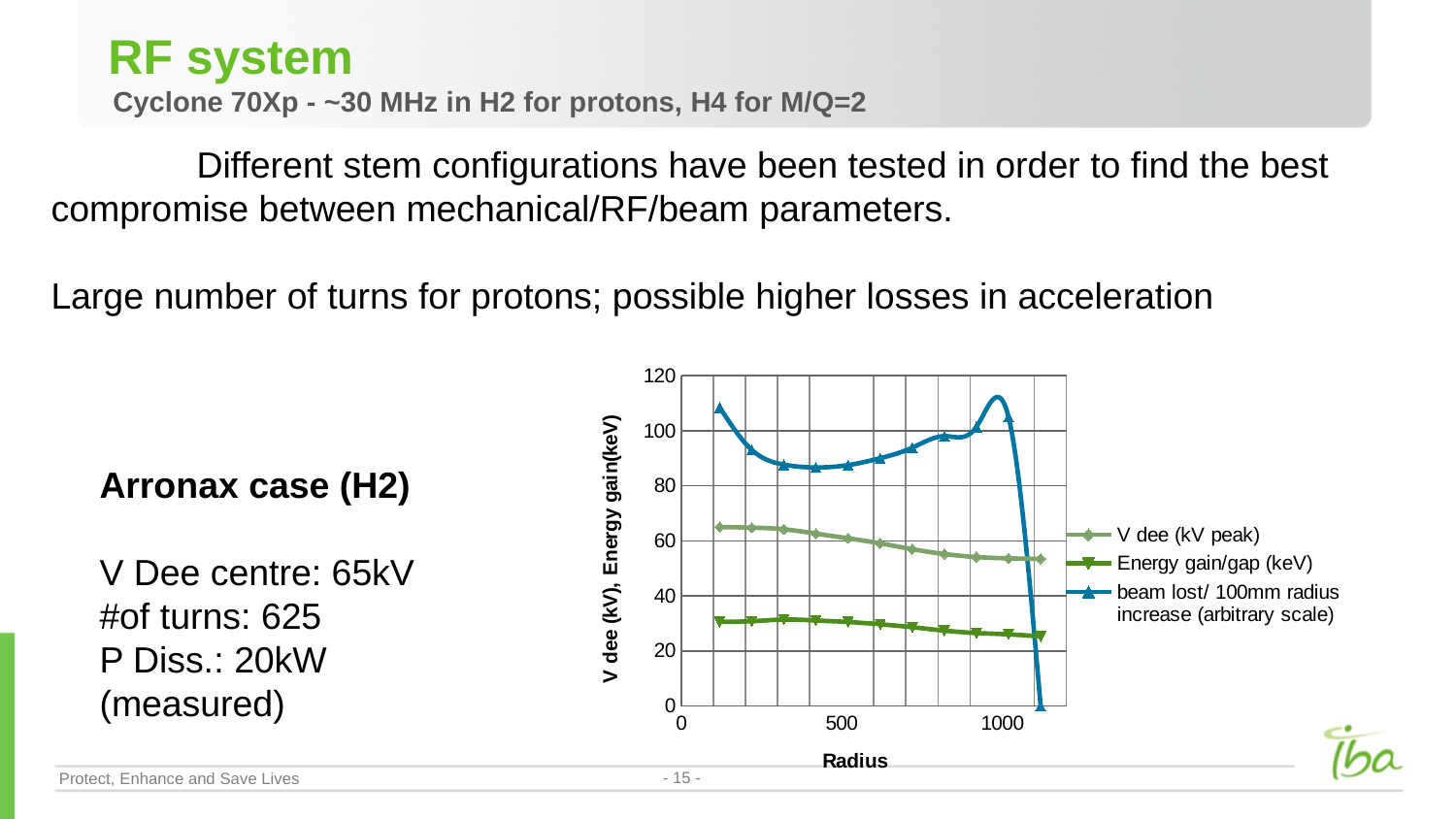
What is the label of the y axis of the chart? V dee (kV), Energy gain(keV) Is the value of the beam lost/ 100mm radius increase series at radius 500 greater or less than 100? less How many series does the chart legend list? 3 Does the V dee (kV peak) series rise or fall as the radius increases? fall Does the Energy gain/gap (keV) series rise or fall as the radius increases? fall Is the value of the V dee (kV peak) series at the smallest radius greater or less than 60? greater At radius 500, which is larger: the V dee (kV peak) value or the Energy gain/gap (keV) value? V dee (kV peak) Is the value of the Energy gain/gap (keV) series at radius 500 greater or less than 40? less What is the label of the x axis of the chart? Radius What kind of chart is shown on the slide? line chart